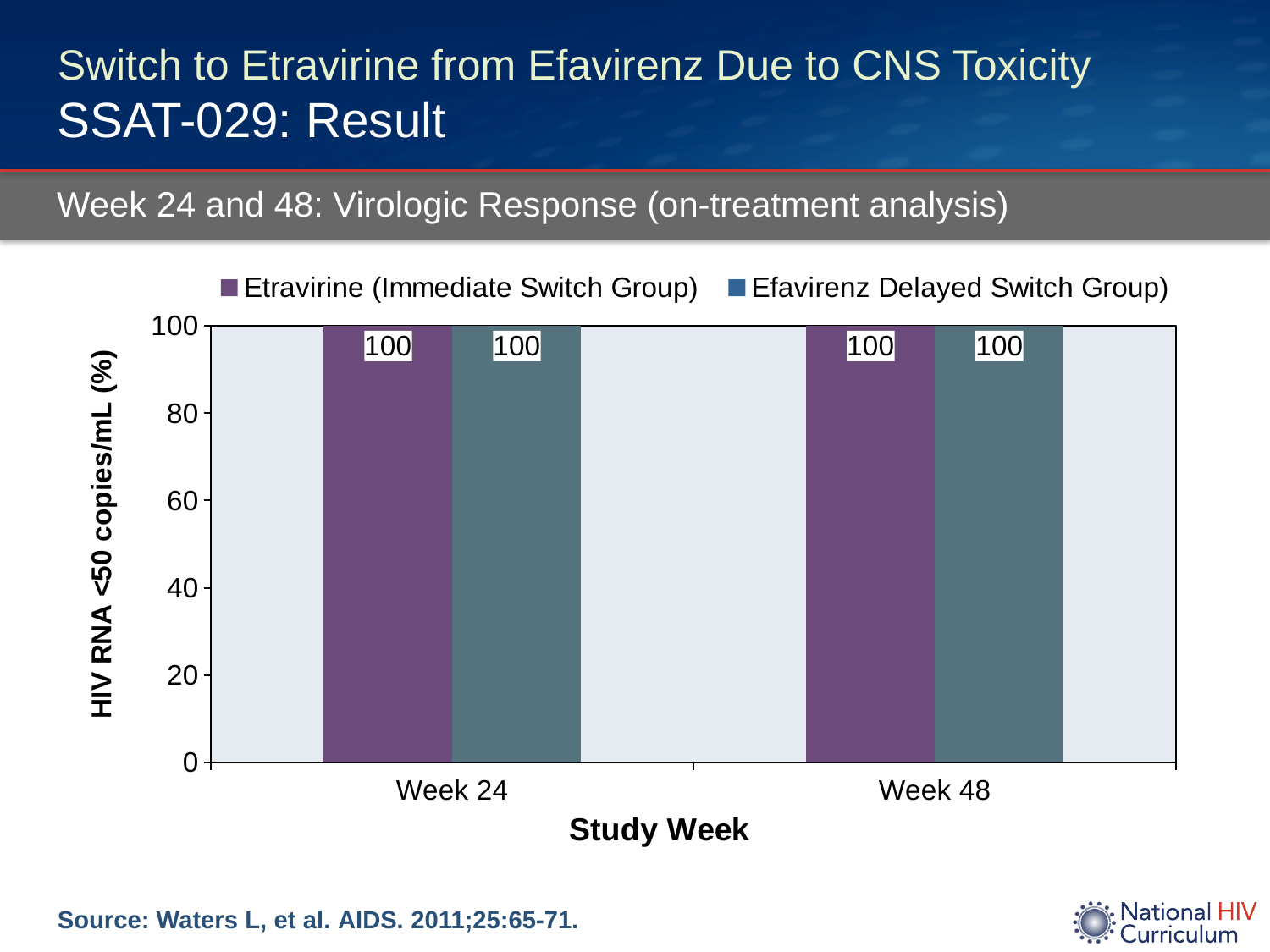
What is the value for Etravirine (Immediate Switch Group) at Week 24? 100 What is the label of the x axis? Study Week What is the label of the y axis? HIV RNA <50 copies/mL (%) What is the difference between the Etravirine (Immediate Switch Group) and Efavirenz Delayed Switch Group values at Week 24? 0 Does the value for Efavirenz Delayed Switch Group rise, fall, or stay the same from Week 24 to Week 48? stays the same How many series does the legend list? 2 What is the value for Etravirine (Immediate Switch Group) at Week 48? 100 What kind of chart is shown on the slide? bar chart What is the difference between the Week 24 and Week 48 values for Etravirine (Immediate Switch Group)? 0 What is the value for Efavirenz Delayed Switch Group at Week 48? 100 What is the value for Efavirenz Delayed Switch Group at Week 24? 100 How many study week categories are shown on the x axis? 2